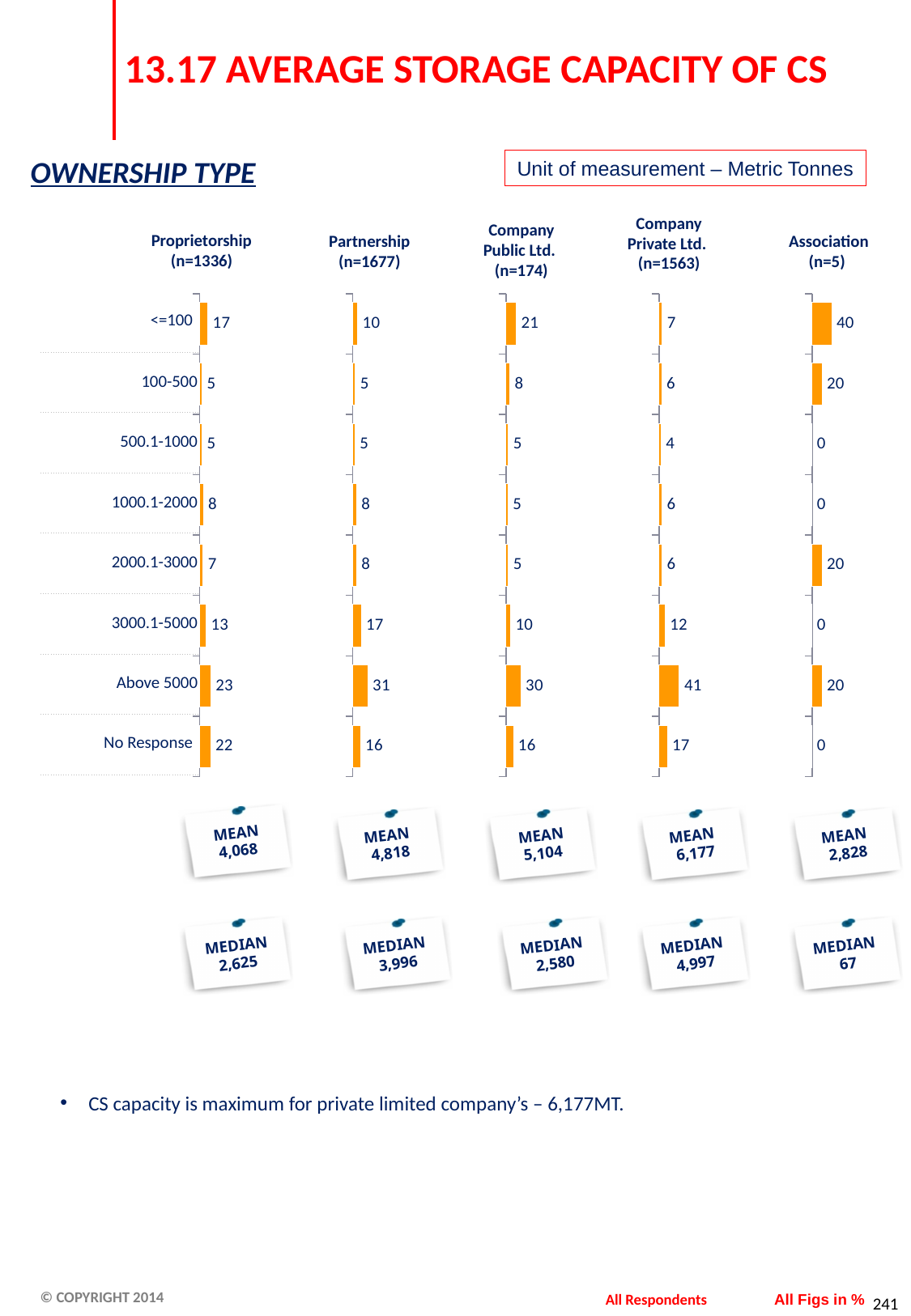
In the Company Private Ltd. chart, which category has the lowest value? 500.1-1000 In the Partnership chart, what is the value for 3000.1-5000? 17 How many categories are shown in the Company Public Ltd. chart? 8 In the Partnership chart, what is the difference between Above 5000 and No Response? 15 In the Proprietorship chart, what is the value for Above 5000? 23 In the Company Private Ltd. chart, which category has the highest value? Above 5000 In the Company Public Ltd. chart, what is the value for <=100? 21 In the Association chart, which category has the highest value? <=100 What unit of measurement is stated on the slide? Metric Tonnes What kind of chart is the Association chart? bar chart In the Proprietorship chart, which is larger, the value for <=100 or the value for 3000.1-5000? <=100 In the Company Private Ltd. chart, what is the value for No Response? 17